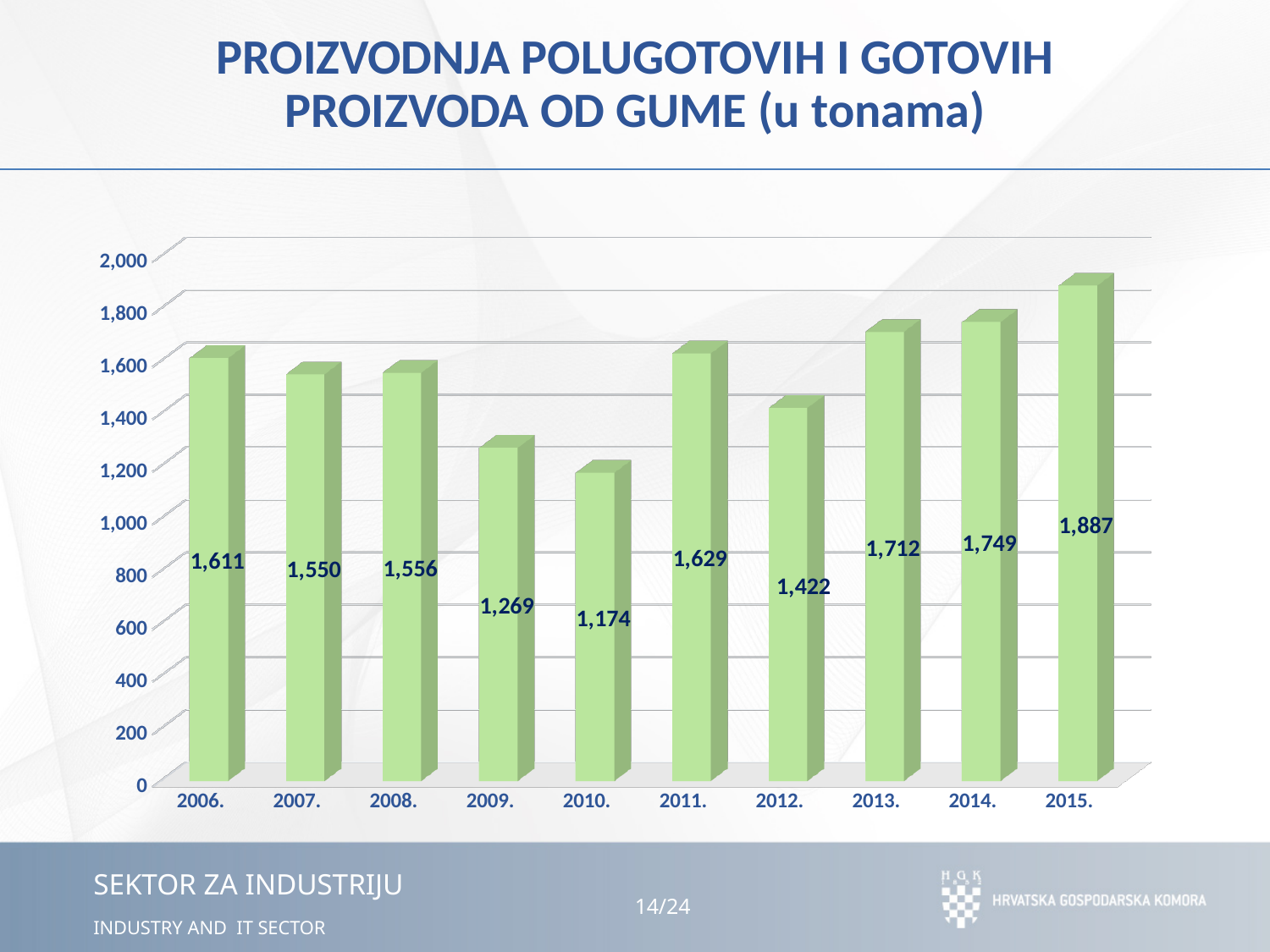
How many years are shown on the x axis? 10 What is the difference between the values for 2015. and 2014.? 138 Do the values rise or fall from 2012. to 2015.? rise What is the value for 2013.? 1,712 Is the value for 2009. greater or less than 1,400? less What is the value for 2006.? 1,611 Which is larger, the value for 2007. or the value for 2008.? 2008. What is the difference between the values for 2011. and 2012.? 207 What kind of chart is shown on the slide? bar chart Which year has the highest value? 2015. Which year has the lowest value? 2010. What is the value for 2010.? 1,174